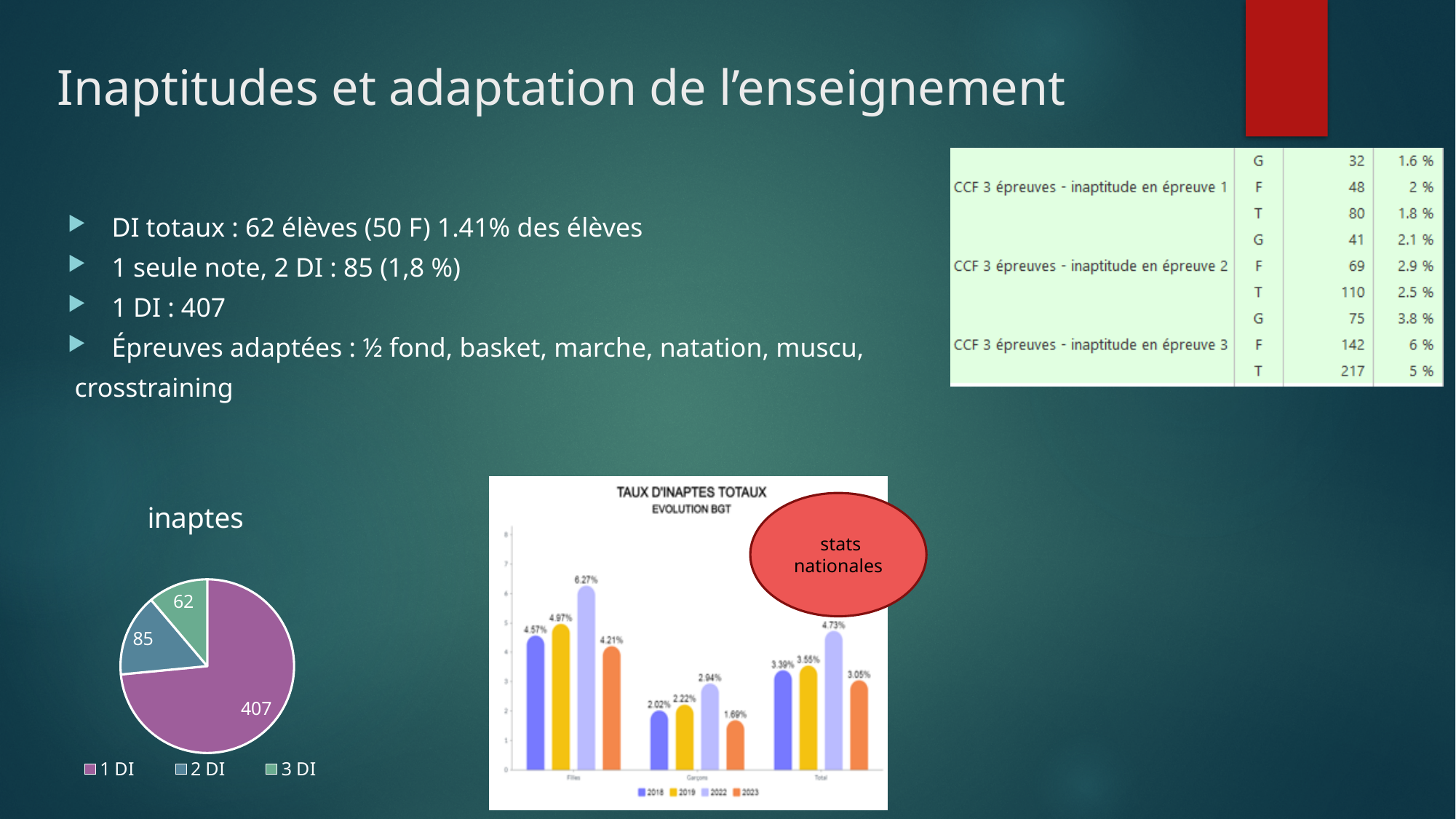
In the pie chart titled "inaptes", how many slices are there? 3 In the pie chart titled "inaptes", what is the difference between the values for 2 DI and 3 DI? 23 In the pie chart titled "inaptes", what is the value for 1 DI? 407 In the bar chart titled "TAUX D'INAPTES TOTAUX", is the value for Total in 2019 larger or smaller than the value for Total in 2023? larger In the pie chart titled "inaptes", what is the value for 3 DI? 62 What kind of chart is the chart titled "TAUX D'INAPTES TOTAUX"? bar chart In the pie chart titled "inaptes", which category has the largest slice? 1 DI In the bar chart titled "TAUX D'INAPTES TOTAUX", what is the value for Garçons in 2023? 1.69% In the bar chart titled "TAUX D'INAPTES TOTAUX", how many series does the legend list? 4 In the pie chart titled "inaptes", which category has the smallest slice? 3 DI In the bar chart titled "TAUX D'INAPTES TOTAUX", what is the value for Filles in 2022? 6.27% In the bar chart titled "TAUX D'INAPTES TOTAUX", which year has the highest value for Total? 2022